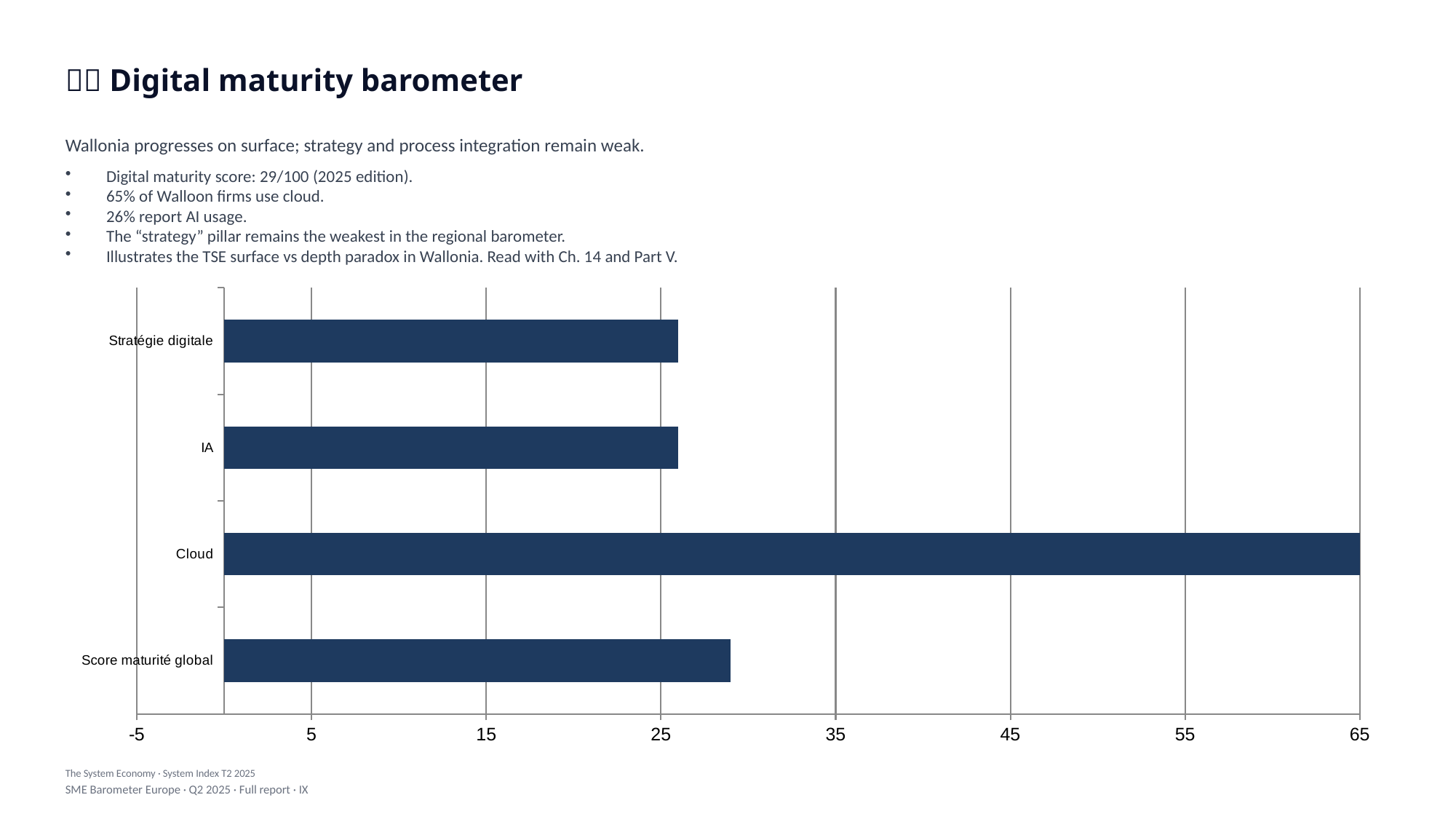
Is the value for Stratégie digitale greater or less than 35? less Is the value for IA greater or less than 35? less What is the title of the slide containing the chart? Digital maturity barometer Is the value for Score maturité global greater or less than 25? greater Which is larger, the value for Cloud or the value for Score maturité global? Cloud Which is larger, the value for Score maturité global or the value for IA? Score maturité global What is the value for Cloud in the chart? 65 How many categories are plotted in the chart? 4 What kind of chart is shown on the slide? bar chart Which category has the highest value in the chart? Cloud What is the highest tick value shown on the horizontal axis of the chart? 65